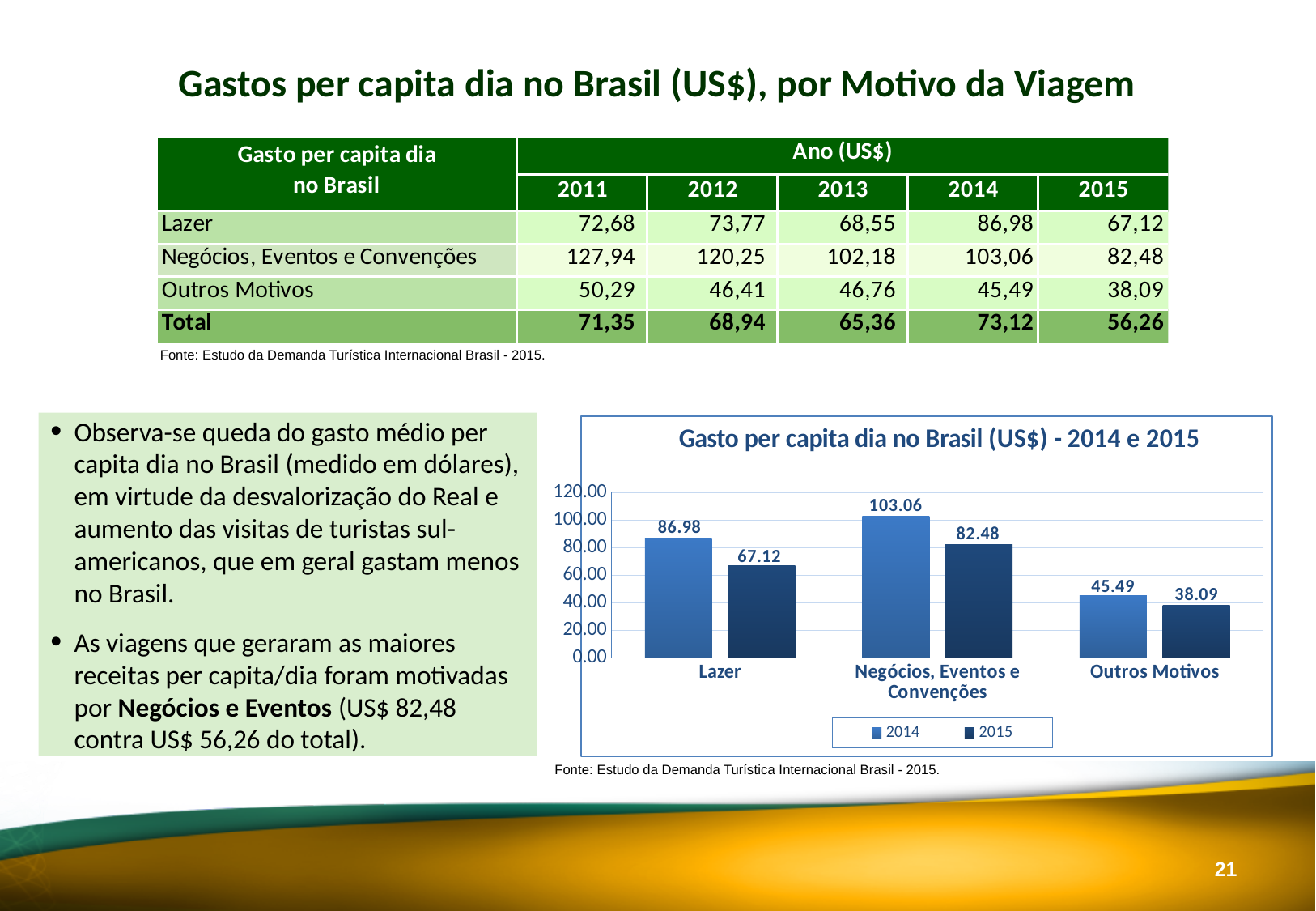
Which category has the highest value in the 2015 series? Negócios, Eventos e Convenções Which is larger: the 2015 value for Lazer or the 2015 value for Outros Motivos? Lazer How many categories are shown on the x axis of the chart? 3 What kind of chart is shown on the slide? bar chart What is the value for Negócios, Eventos e Convenções in the 2015 series? 82.48 What is the value for Outros Motivos in the 2014 series? 45.49 What is the difference between the 2014 and 2015 values for Lazer? 19.86 How many series does the chart legend list? 2 What is the difference between the 2014 and 2015 values for Negócios, Eventos e Convenções? 20.58 Which category has the lowest value in the 2014 series? Outros Motivos Is the 2014 value for Negócios, Eventos e Convenções greater or less than 100.00? greater What is the value for Lazer in the 2014 series? 86.98